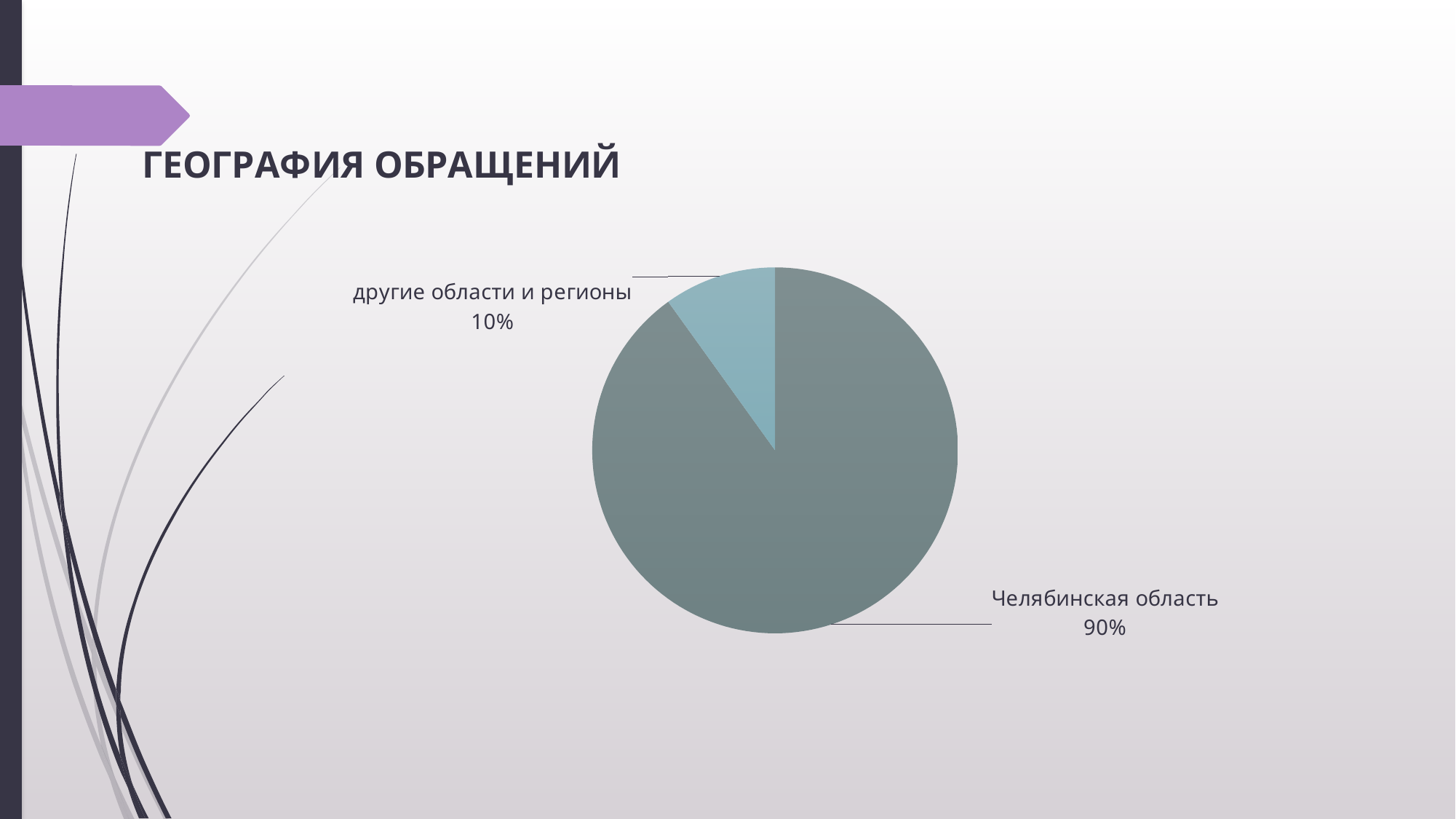
How many slices does the pie chart have? 2 What share of the pie does Челябинская область have? 90% What is the difference in percentage points between Челябинская область and другие области и регионы? 80 Which is larger: the share for Челябинская область or the share for другие области и регионы? Челябинская область What is the total of the two slice percentages shown on the pie chart? 100% Which slice of the pie is the smallest? другие области и регионы Which slice of the pie is the largest? Челябинская область What kind of chart is shown on the slide? pie chart What share of the pie does другие области и регионы have? 10% What is the title of the slide containing the pie chart? ГЕОГРАФИЯ ОБРАЩЕНИЙ